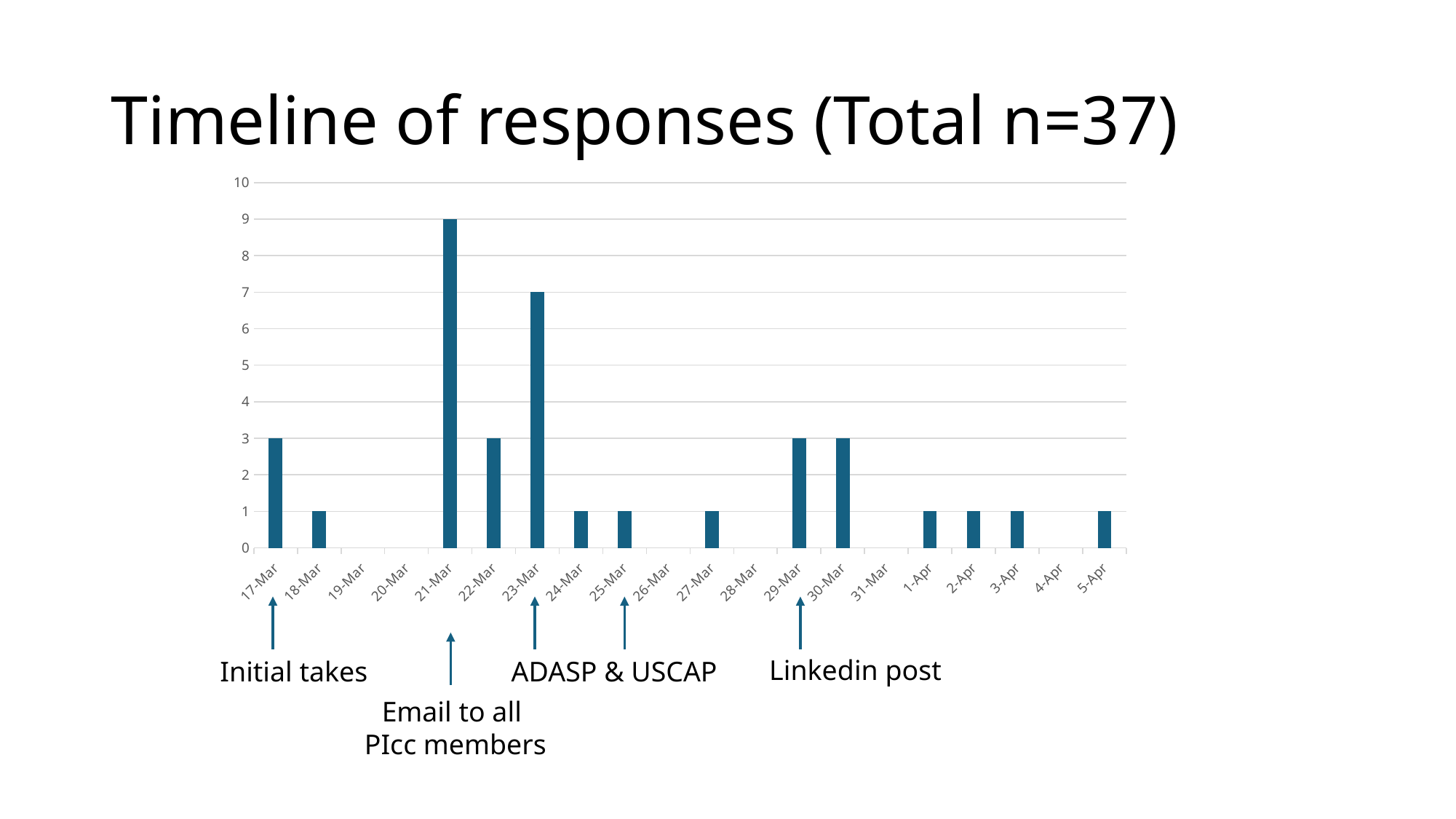
Is the value for 21-Mar greater or less than 8? greater What is the difference between the responses on 21-Mar and 23-Mar? 2 How many responses were received on 17-Mar? 3 What is the title of the chart on the slide? Timeline of responses (Total n=37) What event is annotated with an arrow at 29-Mar? Linkedin post How many date categories are shown on the x axis? 20 How many responses were received on 21-Mar? 9 What type of chart is shown on the slide? bar chart How many responses were received on 23-Mar? 7 Which date had more responses, 22-Mar or 23-Mar? 23-Mar Which date has the highest number of responses? 21-Mar How many responses were received on 30-Mar? 3